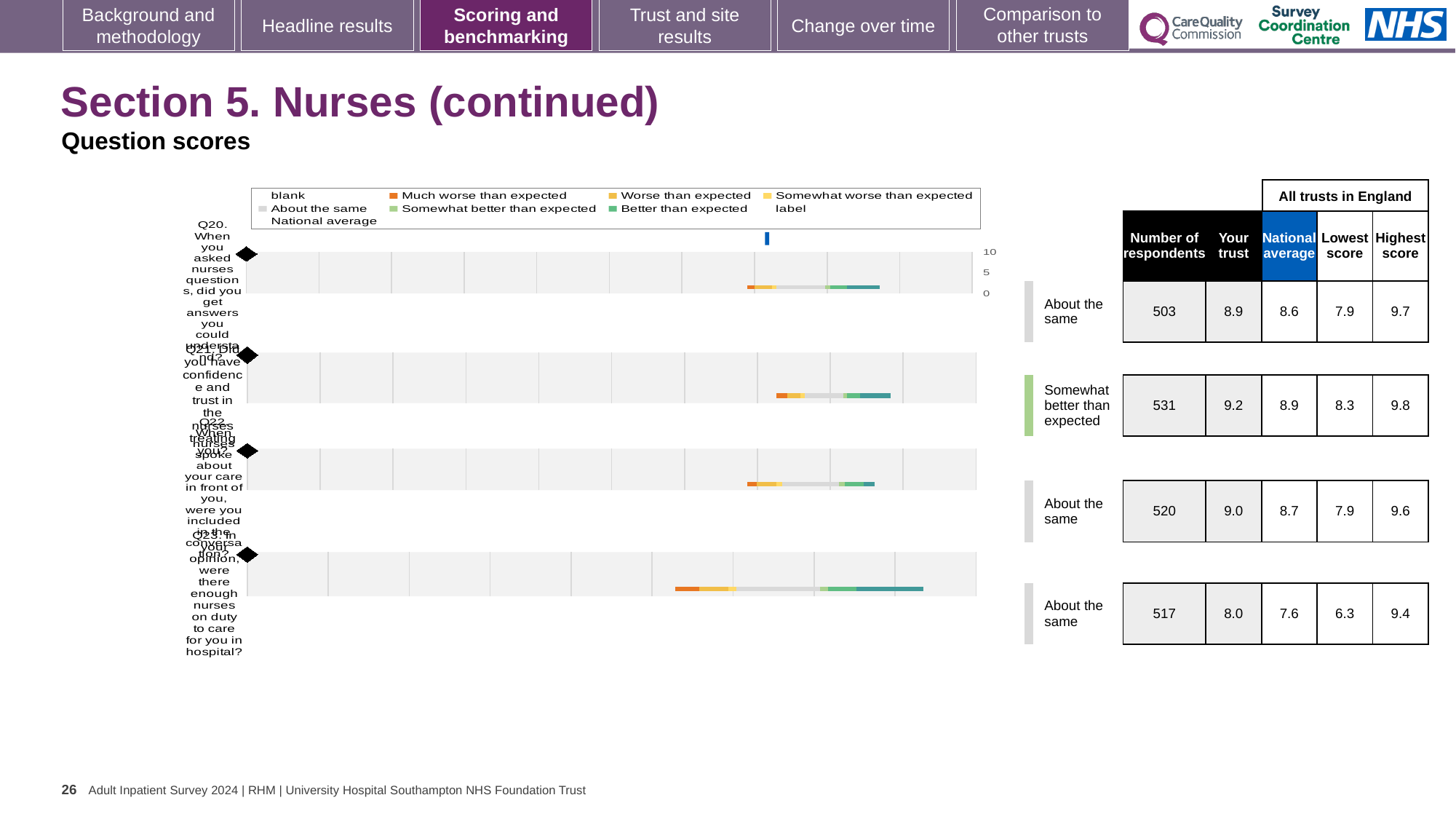
What is the highest value shown on the chart's score axis? 10 How many questions (bars) are plotted in the chart? 4 What kind of chart is shown on the slide? bar chart What is the 'Your trust' score for Q20 in the table beside the chart? 8.9 Which question has the lowest 'Your trust' score in the table beside the chart? Q23 Which question is rated 'Somewhat better than expected' in the benchmark labels beside the chart? Q21 How many respondents are listed for Q22 in the table beside the chart? 520 Which question has the highest 'Your trust' score in the table beside the chart? Q21 What is the difference between the 'Your trust' score and the national average for Q23 in the table beside the chart? 0.4 Which colour does the legend use for 'Much worse than expected'? orange What is the lowest score across all trusts in England for Q23 in the table beside the chart? 6.3 What is the national average for Q21 in the table beside the chart? 8.9